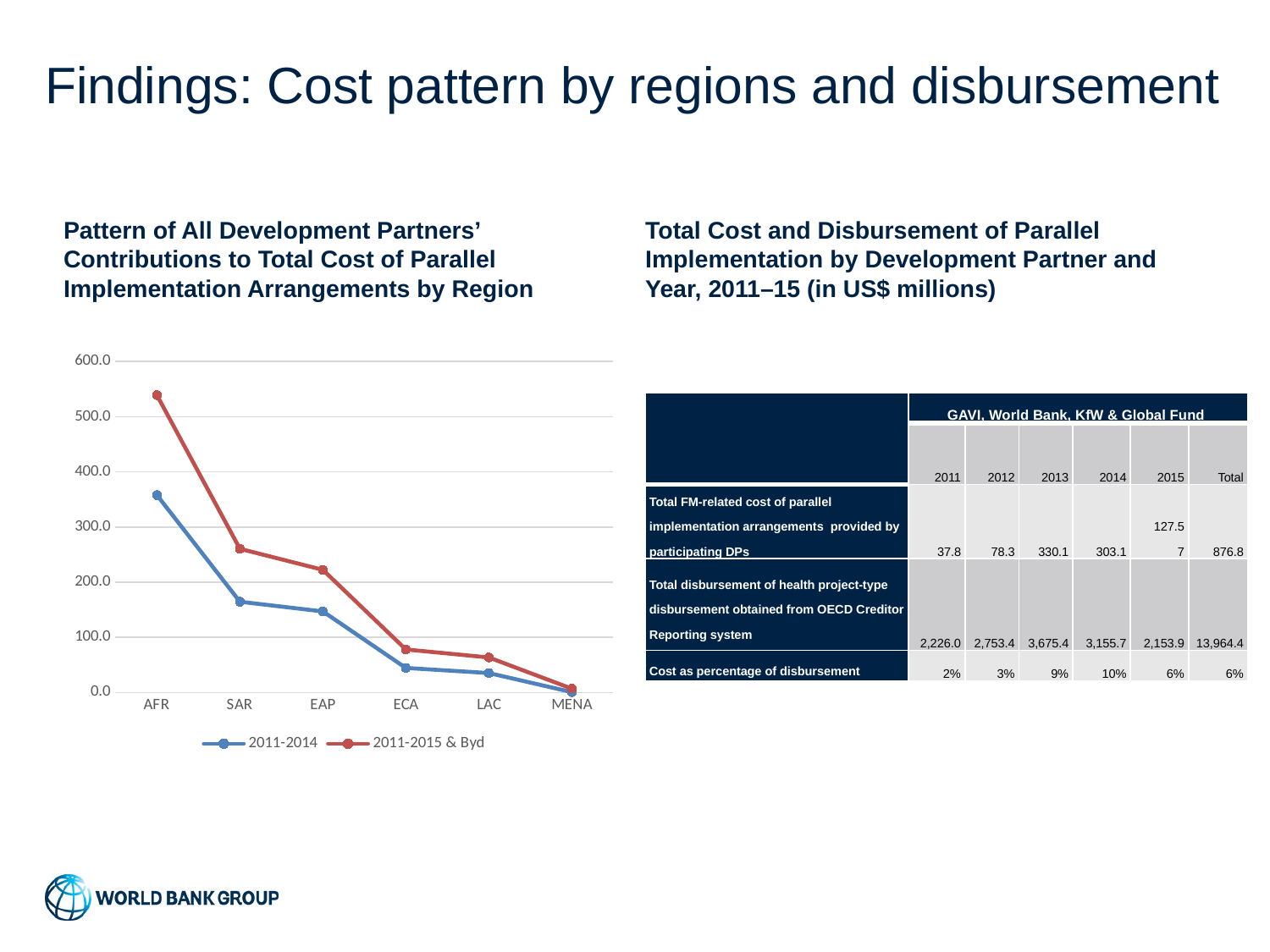
Which region has the lowest value for the 2011-2014 series? MENA How many series does the legend of the line chart list? 2 Is the value for AFR in the 2011-2015 & Byd series greater or less than 500? greater What colour is the line for the 2011-2014 series? blue Do the values of the 2011-2015 & Byd series rise or fall moving from AFR to MENA along the x axis? fall For AFR, which series has the larger value, 2011-2014 or 2011-2015 & Byd? 2011-2015 & Byd Is the value for SAR in the 2011-2014 series greater or less than 200? less Is the value for ECA in the 2011-2015 & Byd series greater or less than 100? less What kind of chart is shown on the slide? line chart How many regions are plotted along the x axis of the line chart? 6 Which region has the highest value for the 2011-2015 & Byd series? AFR